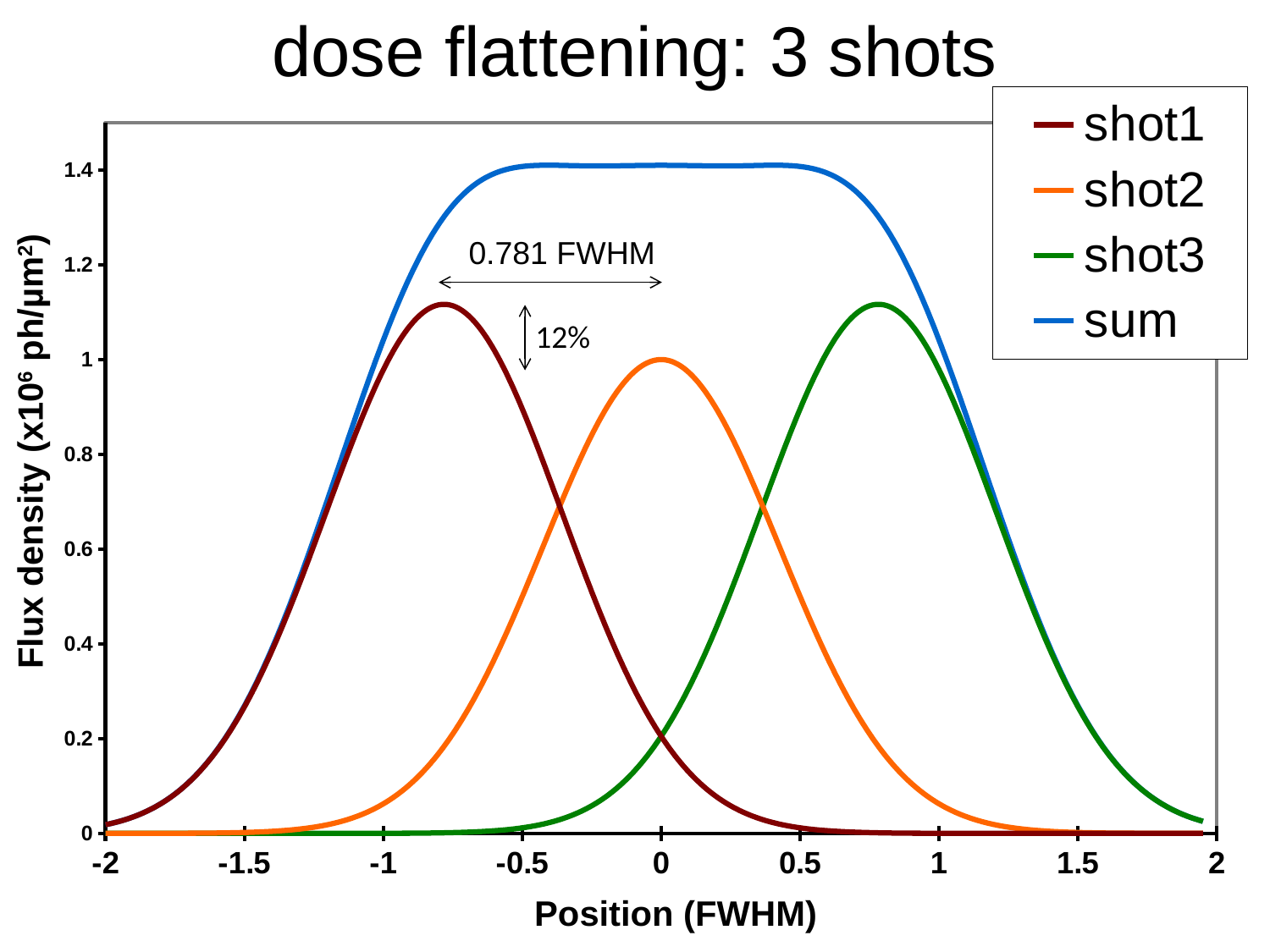
Is the value of the sum curve at position 0 greater or less than 1.2? greater Is the value of shot3 at position 0 greater or less than 0.4? less Is the value of shot2 at position 1 greater or less than 0.2? less How many series does the legend list? 4 Which series reaches the highest flux density? sum What is the label of the x axis? Position (FWHM) What spacing between the shot peaks is annotated on the chart? 0.781 FWHM At position 0, which series has the higher value, shot1 or shot2? shot2 What kind of chart is shown on the slide? line chart What is the title of the chart? dose flattening: 3 shots At position -1, which series has the higher value, shot1 or shot2? shot1